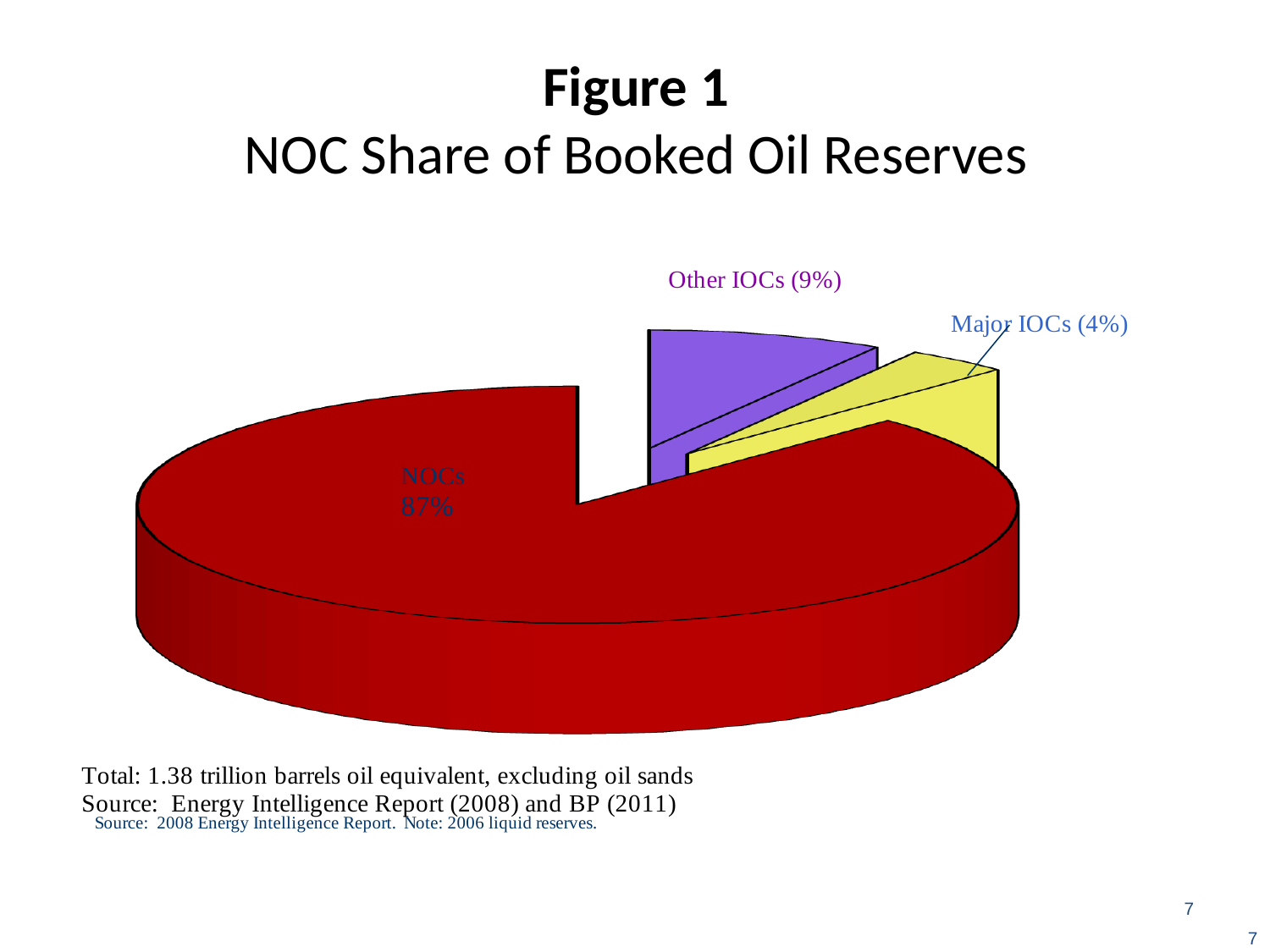
What share of booked oil reserves do NOCs hold? 87% What is the difference in percentage points between the Other IOCs share and the Major IOCs share? 5 What is the title of the chart shown as Figure 1? NOC Share of Booked Oil Reserves What share of booked oil reserves do Other IOCs hold? 9% What colour is the NOCs slice of the pie chart? red Which is larger, the share for Other IOCs or the share for Major IOCs? Other IOCs What is the difference in percentage points between the NOCs share and the Other IOCs share? 78 Which category has the smallest share of booked oil reserves? Major IOCs What share of booked oil reserves do Major IOCs hold? 4% How many slices does the pie chart have? 3 Which category has the largest share of booked oil reserves? NOCs What kind of chart is shown on the slide? pie chart